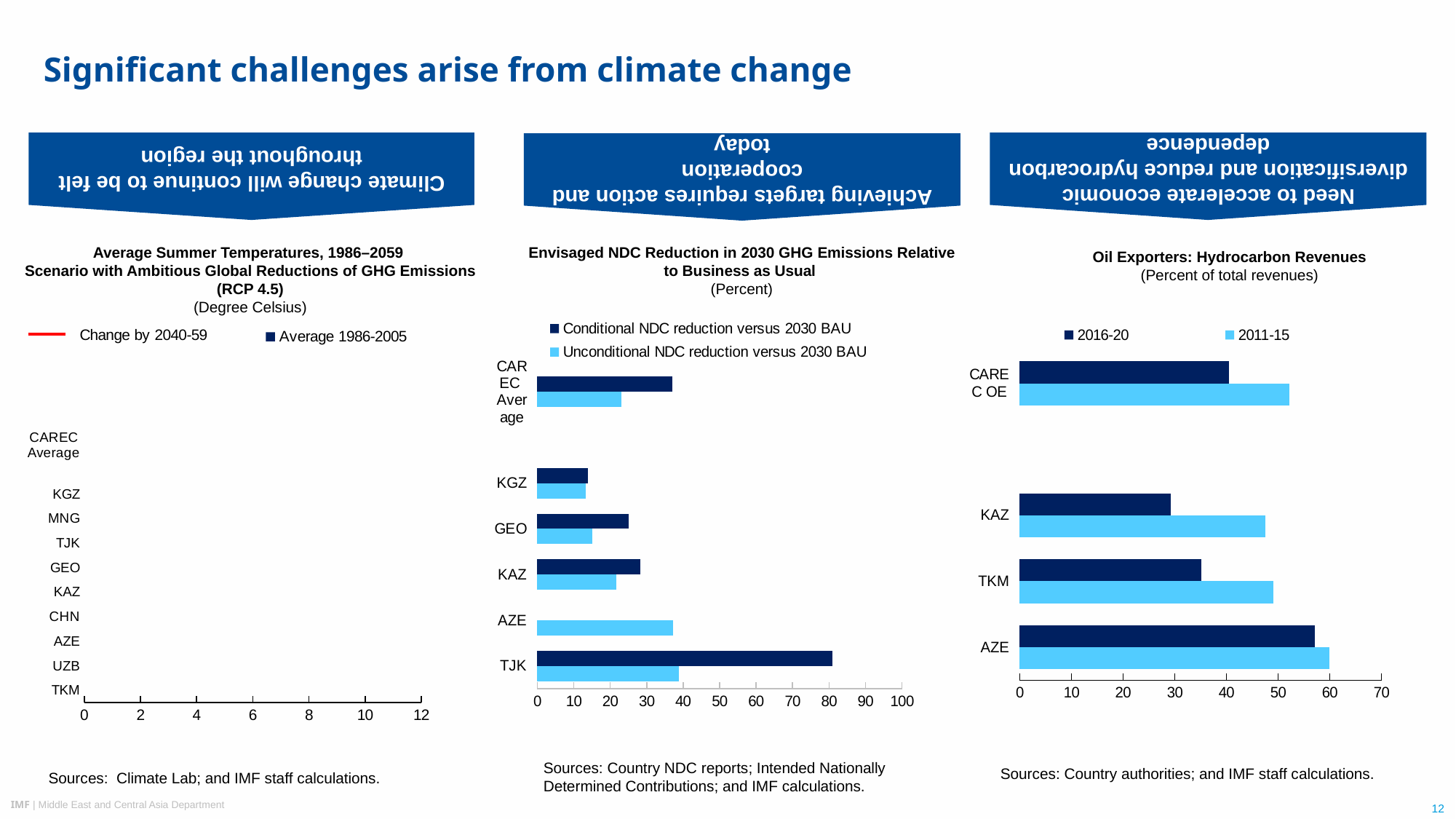
In the 'Envisaged NDC Reduction in 2030 GHG Emissions' chart, which country has the highest conditional NDC reduction versus 2030 BAU? TJK How many series does the legend of the 'Oil Exporters: Hydrocarbon Revenues' chart list? 2 In the 'Envisaged NDC Reduction in 2030 GHG Emissions' chart, which country has no conditional NDC reduction bar? AZE How many countries or groups are shown on the 'Oil Exporters: Hydrocarbon Revenues' chart? 4 In the 'Envisaged NDC Reduction in 2030 GHG Emissions' chart, is the conditional NDC reduction for KGZ greater or less than 20? less In the 'Envisaged NDC Reduction in 2030 GHG Emissions' chart, which country has the lowest unconditional NDC reduction versus 2030 BAU? KGZ In the 'Oil Exporters: Hydrocarbon Revenues' chart, is the 2016-20 value for KAZ larger or smaller than its 2011-15 value? smaller In the 'Oil Exporters: Hydrocarbon Revenues' chart, which country has the highest hydrocarbon revenue share for 2016-20? AZE In the 'Oil Exporters: Hydrocarbon Revenues' chart, which country has the lowest hydrocarbon revenue share for 2016-20? KAZ In the 'Envisaged NDC Reduction in 2030 GHG Emissions' chart, is the conditional NDC reduction for TJK greater or less than 70? greater What kind of chart is the 'Envisaged NDC Reduction in 2030 GHG Emissions Relative to Business as Usual' chart? bar chart In the 'Oil Exporters: Hydrocarbon Revenues' chart, is the 2016-20 value for AZE greater or less than 50? greater